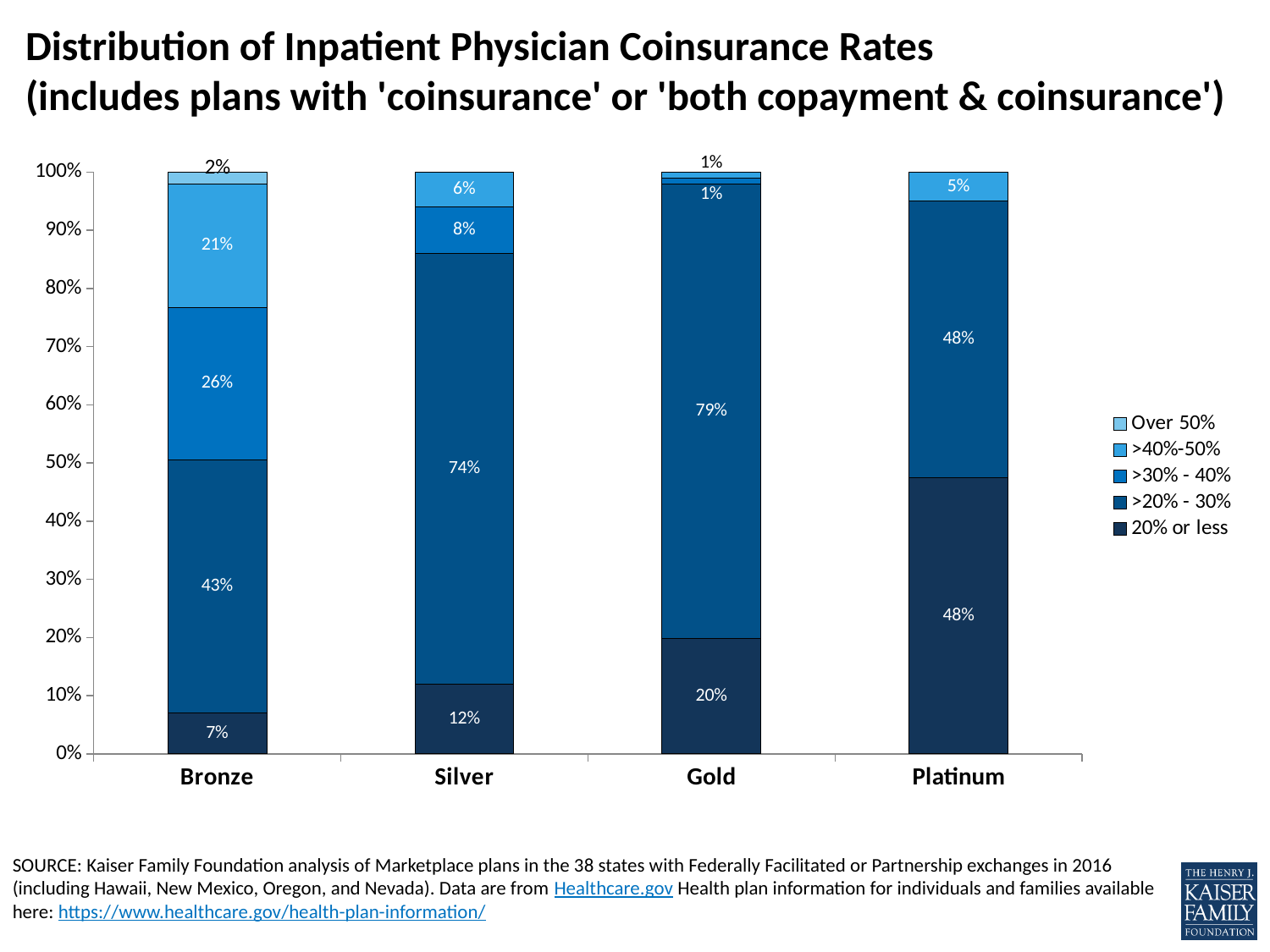
What kind of chart is shown on the slide? Stacked bar chart How many series does the legend list? 5 How many metal levels are shown on the x axis? 4 What is the value of the '20% or less' segment for Platinum? 48% What share of Bronze plans have an inpatient physician coinsurance rate of 20% or less? 7% How many percentage points larger is the '>20% - 30%' segment for Silver than for Bronze? 31 percentage points Which metal level has the smallest '20% or less' segment? Bronze What is the value of the '>40%-50%' segment for Bronze? 21% Which metal level has the largest '>20% - 30%' segment? Gold Which has a larger '>30% - 40%' segment, Bronze or Silver? Bronze What is the value of the '>20% - 30%' segment for Silver? 74% What is the value of the '20% or less' segment for Gold? 20%